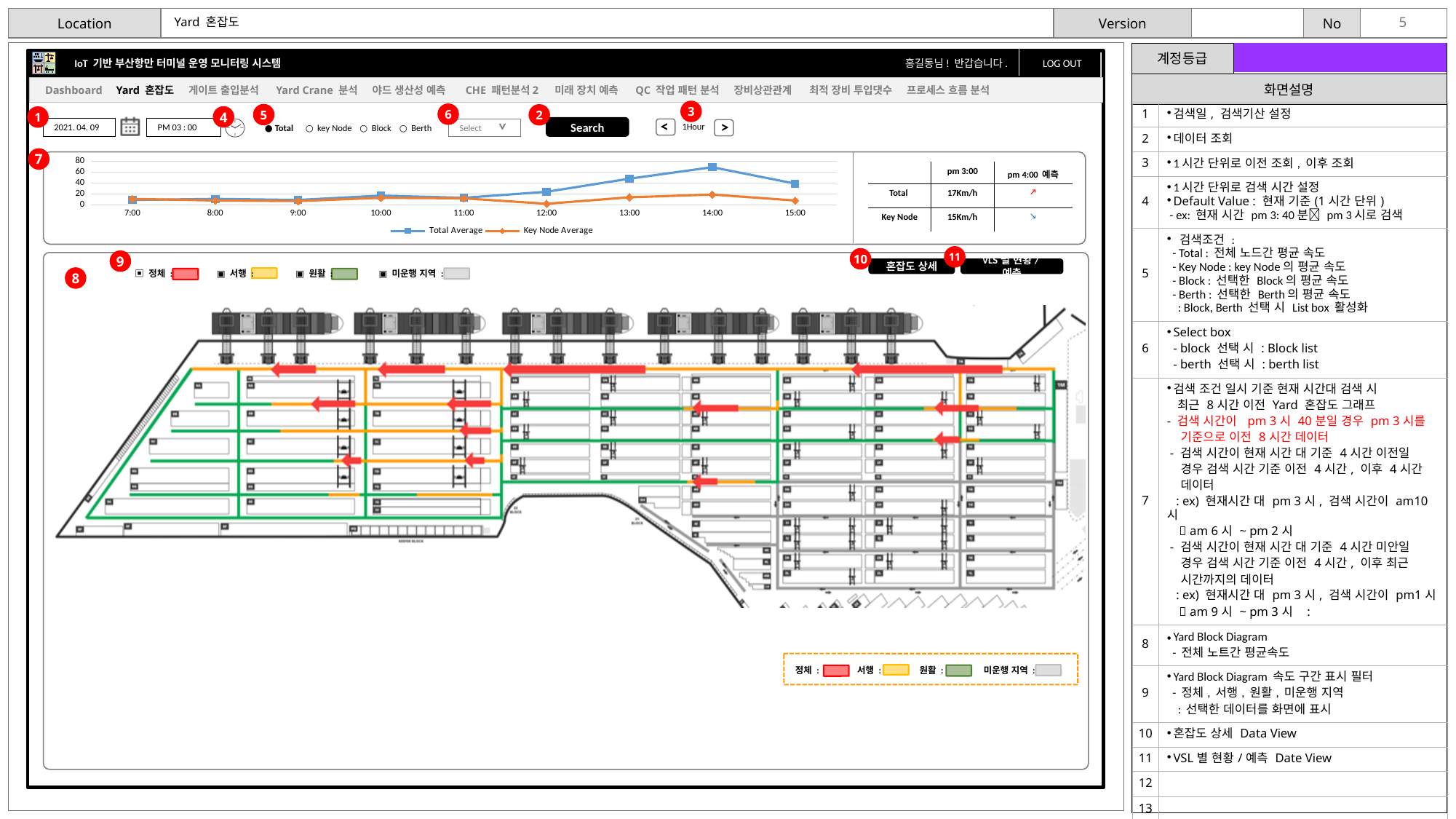
Is the Total Average value at 7:00 greater or less than 20? less At 14:00, which series has the larger value, Total Average or Key Node Average? Total Average Is the Key Node Average value at 14:00 greater or less than 40? less What kind of chart is shown at the top of the screen mockup? line chart How many series does the legend of the line chart list? 2 How many time points are plotted along the x axis of the line chart? 9 Does the Total Average series rise or fall between 12:00 and 14:00? rise Does the Total Average series rise or fall between 14:00 and 15:00? fall At which time does the Total Average series reach its highest value? 14:00 At 12:00, which series has the larger value, Total Average or Key Node Average? Total Average Is the Total Average value at 14:00 greater or less than 60? greater What are the two series named in the line chart's legend? Total Average and Key Node Average